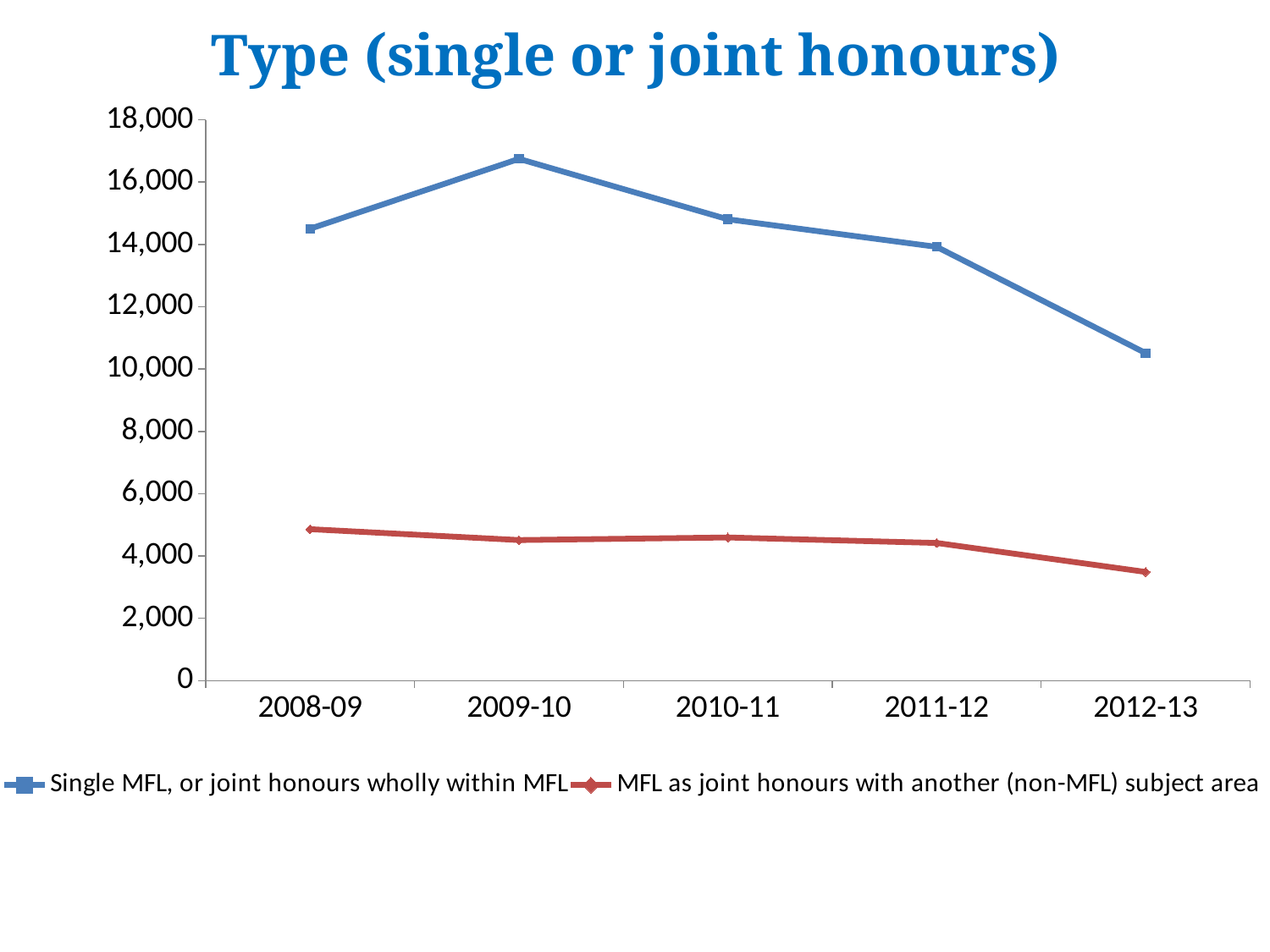
Which series has the larger value in 2010-11: 'Single MFL, or joint honours wholly within MFL' or 'MFL as joint honours with another (non-MFL) subject area'? Single MFL, or joint honours wholly within MFL Is the value for 'Single MFL, or joint honours wholly within MFL' in 2009-10 greater or less than 16,000? greater How many academic years are plotted along the x axis? 5 Is the value for 'MFL as joint honours with another (non-MFL) subject area' in 2012-13 greater or less than 4,000? less In which year is the value for 'Single MFL, or joint honours wholly within MFL' lowest? 2012-13 In which year is the value for 'Single MFL, or joint honours wholly within MFL' highest? 2009-10 How many series does the legend list? 2 What is the title of the chart? Type (single or joint honours) What kind of chart is shown on the slide? line chart In which year is the value for 'MFL as joint honours with another (non-MFL) subject area' lowest? 2012-13 Is the value for 'Single MFL, or joint honours wholly within MFL' in 2012-13 greater or less than 12,000? less Does the value for 'Single MFL, or joint honours wholly within MFL' rise or fall from 2009-10 to 2012-13? fall